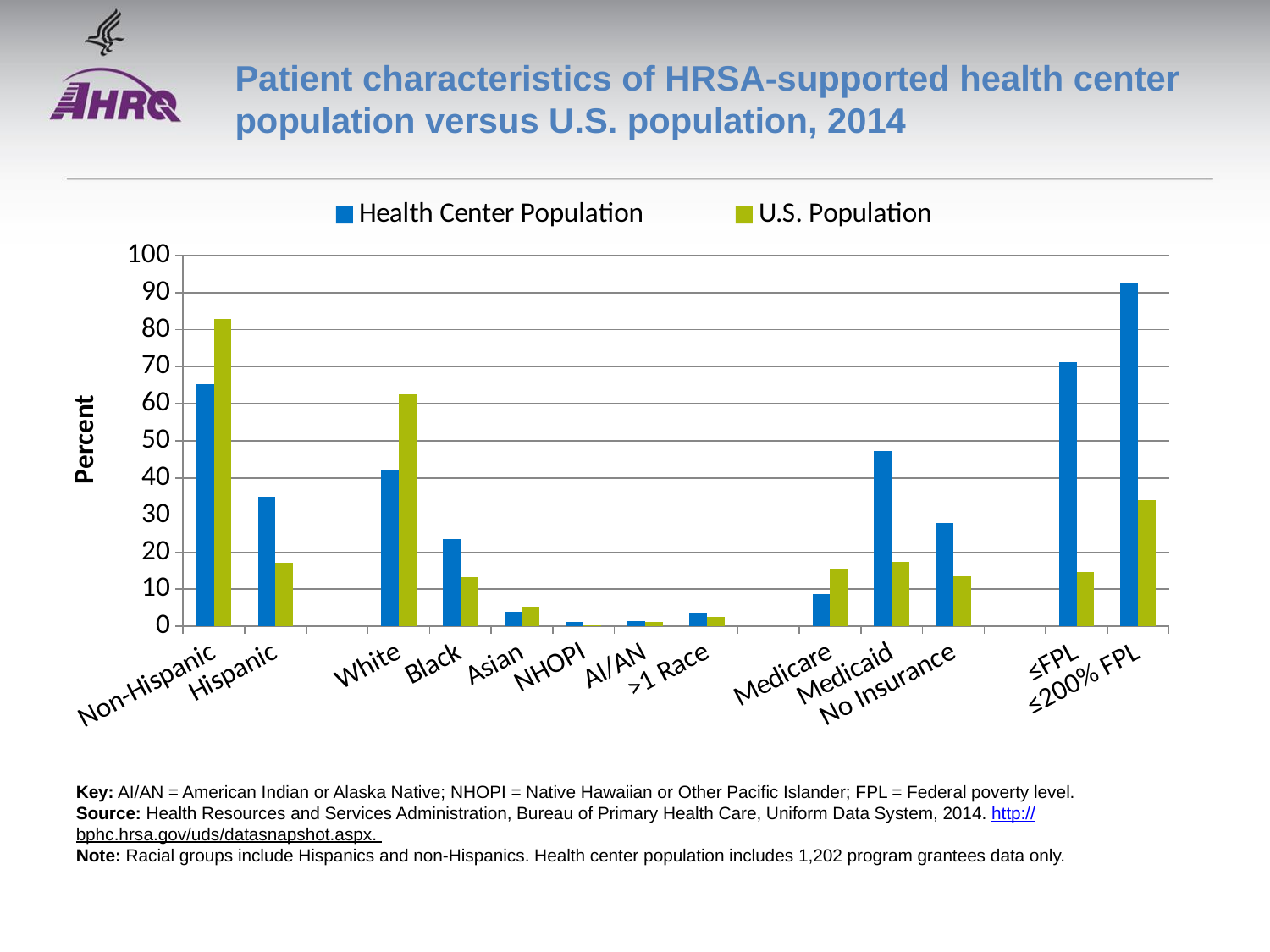
For Medicaid, which series has the larger value, Health Center Population or U.S. Population? Health Center Population Is the Health Center Population value for Medicare greater or less than 10? less Which category has the highest value for the Health Center Population series? ≤200% FPL For White, which series has the larger value, Health Center Population or U.S. Population? U.S. Population Which category has the highest value for the U.S. Population series? Non-Hispanic Is the Health Center Population value for Medicaid greater or less than 40? greater What is the label on the y axis? Percent How many series does the legend list? 2 Is the U.S. Population value for Non-Hispanic greater or less than 80? greater How many categories are shown along the x axis? 13 What kind of chart is shown on the slide? bar chart